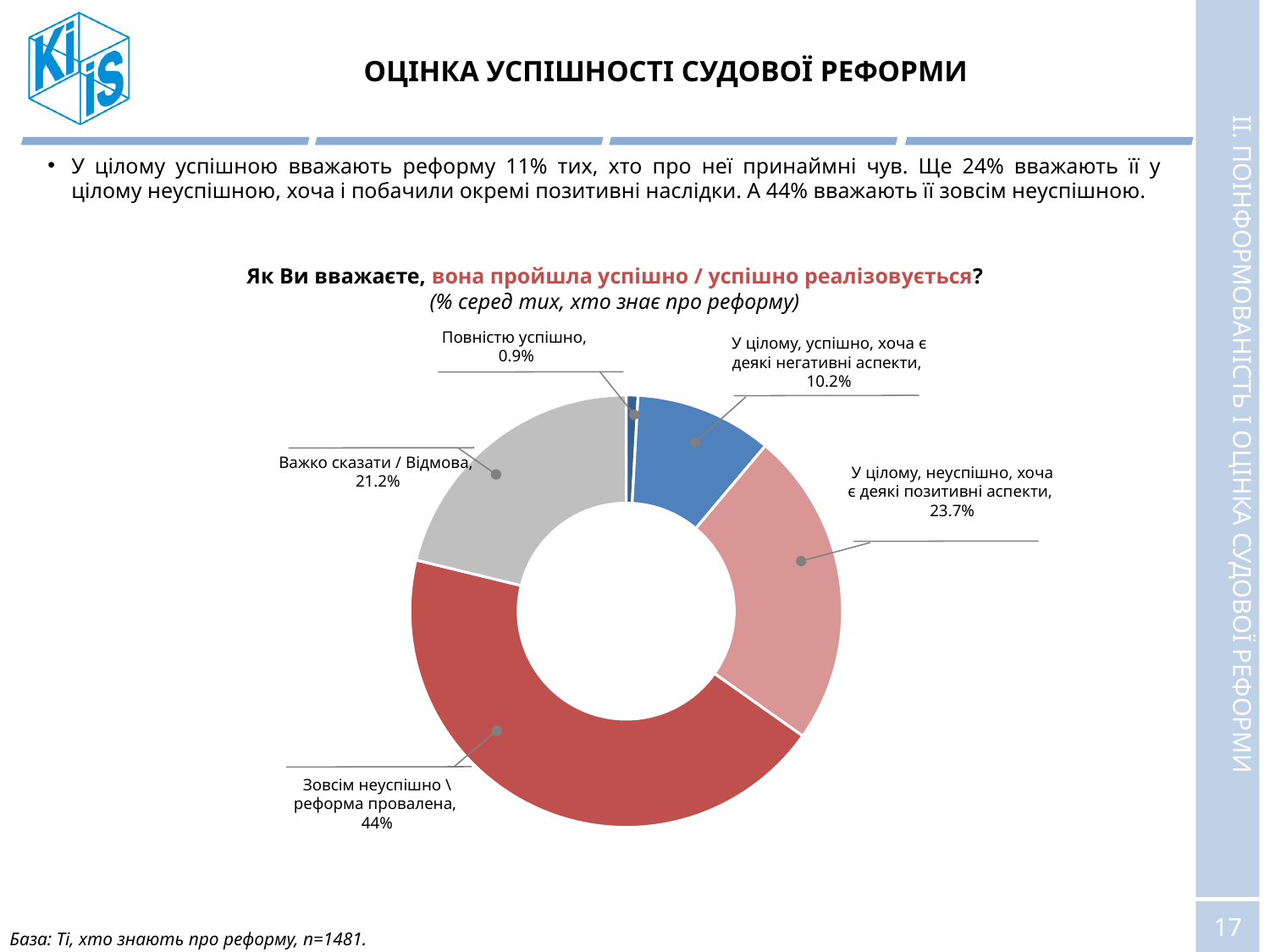
What is the value for "У цілому, успішно, хоча є деякі негативні аспекти"? 10.2% What type of chart is shown on the slide? Donut (pie) chart What is the difference between the shares for "У цілому, неуспішно, хоча є деякі позитивні аспекти" and "Важко сказати / Відмова"? 2.5% Which is larger: the share for "У цілому, успішно, хоча є деякі негативні аспекти" or for "Важко сказати / Відмова"? Важко сказати / Відмова What is the value for "Важко сказати / Відмова"? 21.2% What is the combined share of "Повністю успішно" and "У цілому, успішно, хоча є деякі негативні аспекти"? 11.1% What percentage of respondents answered "Повністю успішно"? 0.9% What percentage of respondents answered "Зовсім неуспішно \ реформа провалена"? 44% Which category has the largest share of the chart? Зовсім неуспішно \ реформа провалена What colour is the slice for "Зовсім неуспішно \ реформа провалена"? Red How many categories are shown in the chart? 5 Which category has the smallest share of the chart? Повністю успішно